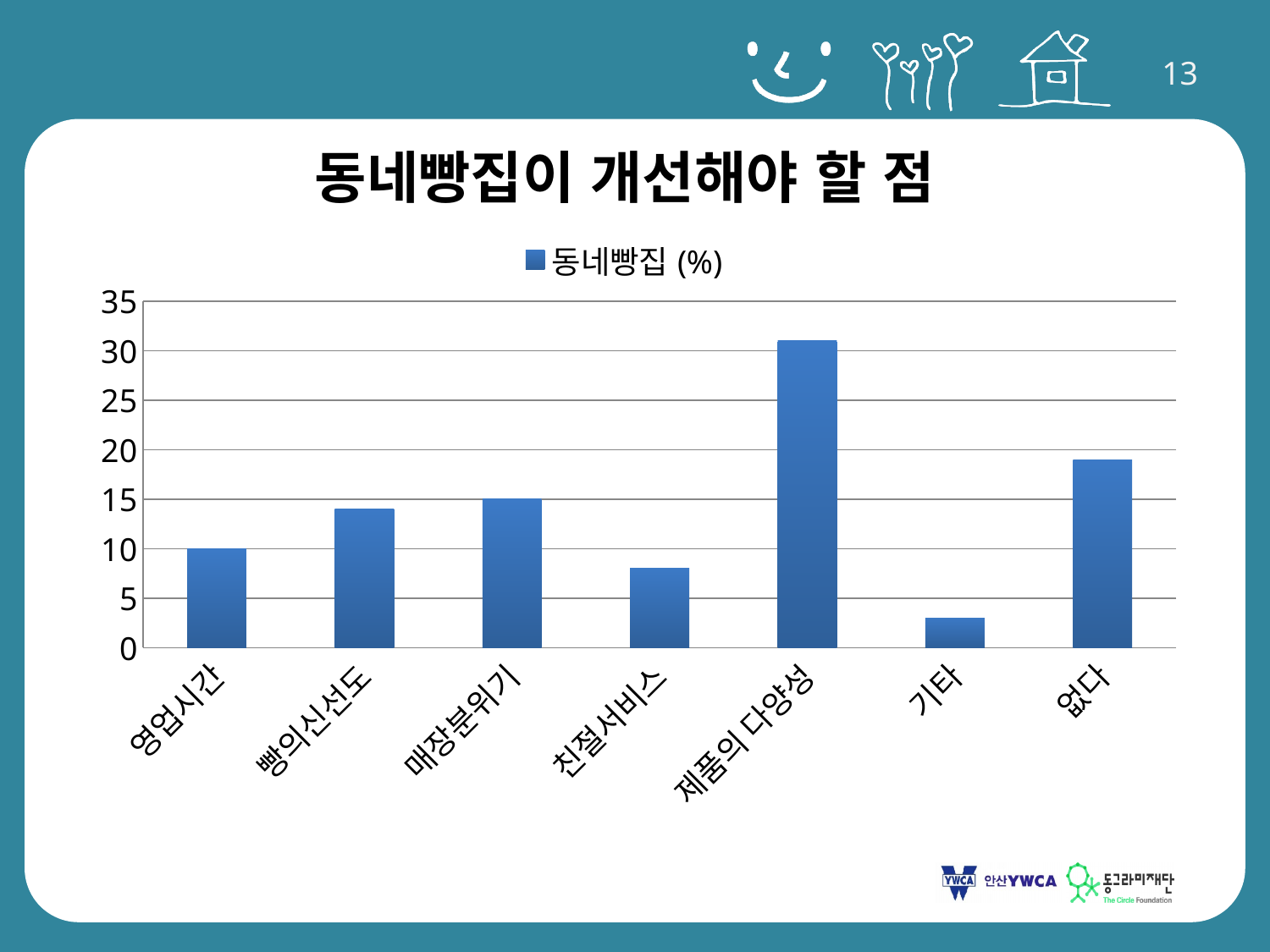
How many categories are shown on the x axis? 7 What is the legend entry for the series? 동네빵집 (%) What kind of chart is shown on the slide? bar chart Is the value for 제품의 다양성 greater or less than 30? greater Is the value for 기타 greater or less than 5? less What is the value for 영업시간? 10 Which category has the lowest value? 기타 Which category has the highest value? 제품의 다양성 Which is larger, the value for 없다 or the value for 친절서비스? 없다 What is the title of the chart? 동네빵집이 개선해야 할 점 What is the value for 매장분위기? 15 How many series does the legend list? 1